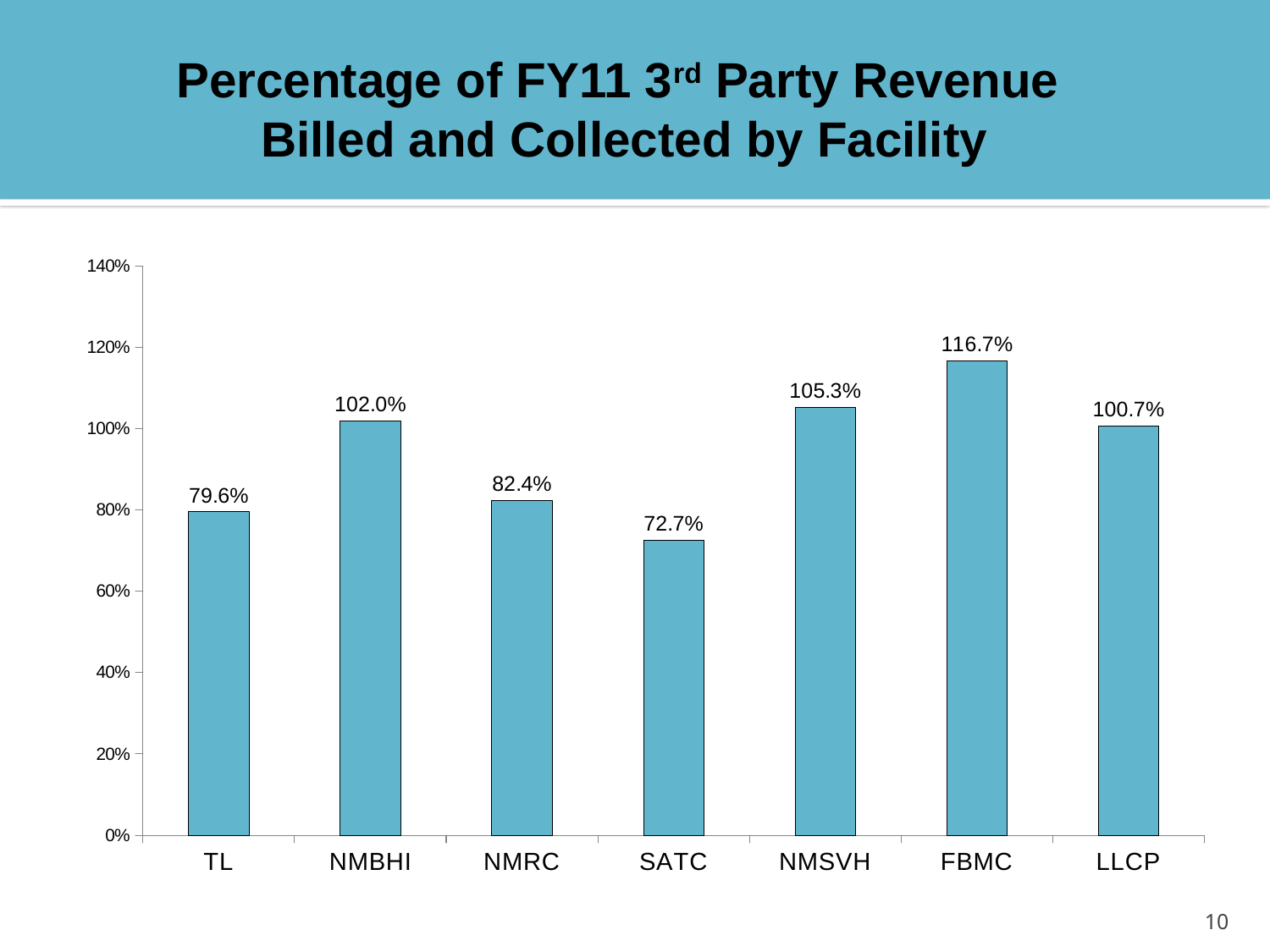
Which facility has the lowest percentage? SATC What is the value for SATC? 72.7% What kind of chart is shown on the slide? bar chart What is the value for NMBHI? 102.0% What is the difference between the values for NMSVH and NMRC? 22.9% Which is larger, the value for NMBHI or the value for NMSVH? NMSVH What is the title of the slide? Percentage of FY11 3rd Party Revenue Billed and Collected by Facility What is the difference between the values for FBMC and TL? 37.1% What is the value for LLCP? 100.7% Which facility has the highest percentage? FBMC Is the value for TL greater or less than 100%? less How many facilities are shown on the x axis? 7